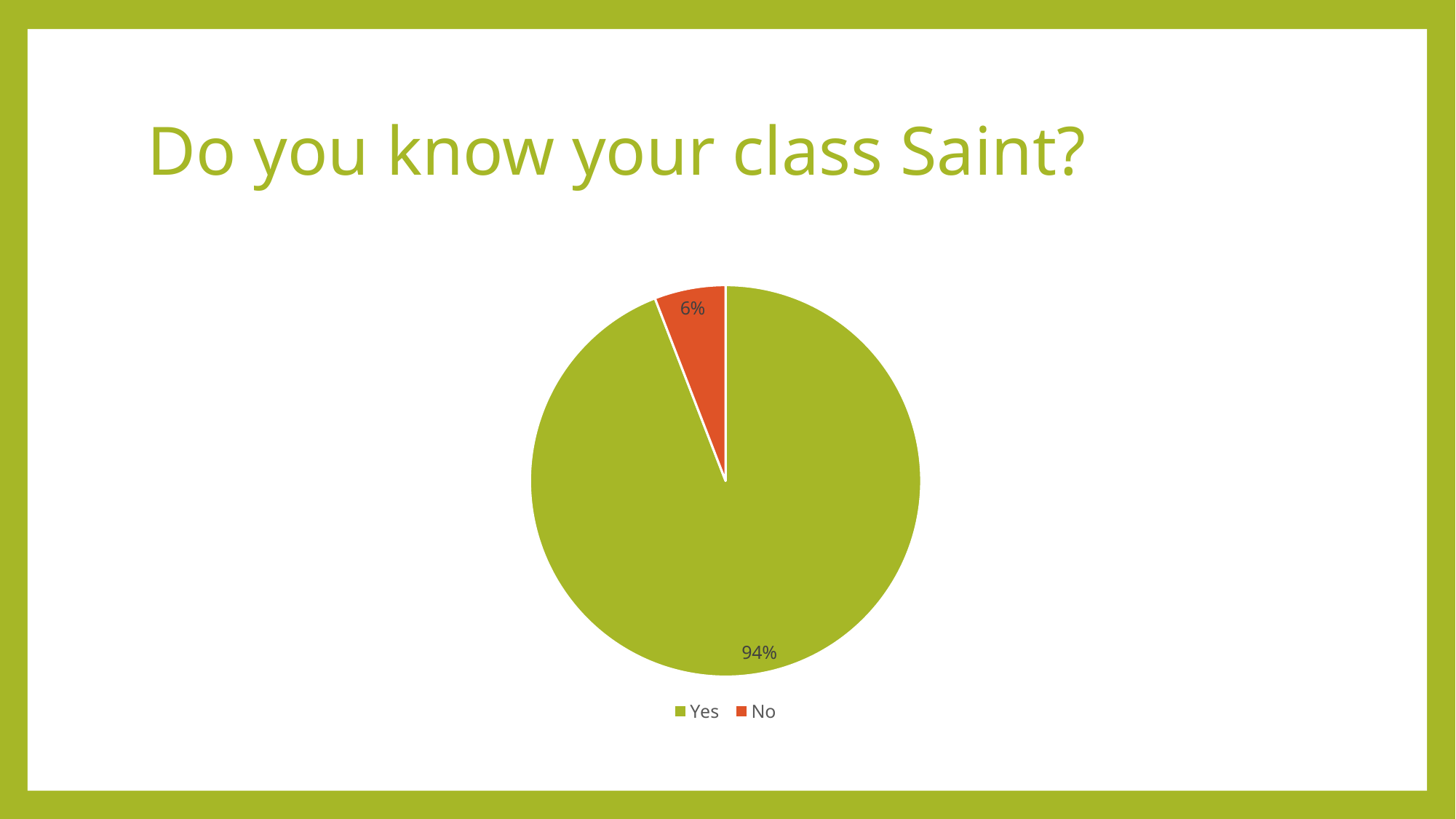
What colour is the Yes slice of the pie? green What share of the pie does the No slice represent? 6% Which response has the smallest share of the pie? No What is the difference in percentage points between the Yes and No slices? 88 What percentage of respondents answered Yes? 94% What percentage of respondents answered No? 6% How many slices does the pie chart have? 2 Which response has the largest share of the pie? Yes How many entries does the legend list? 2 What kind of chart is shown on the slide? pie chart Which slice is larger, Yes or No? Yes What is the title of the slide containing the chart? Do you know your class Saint?